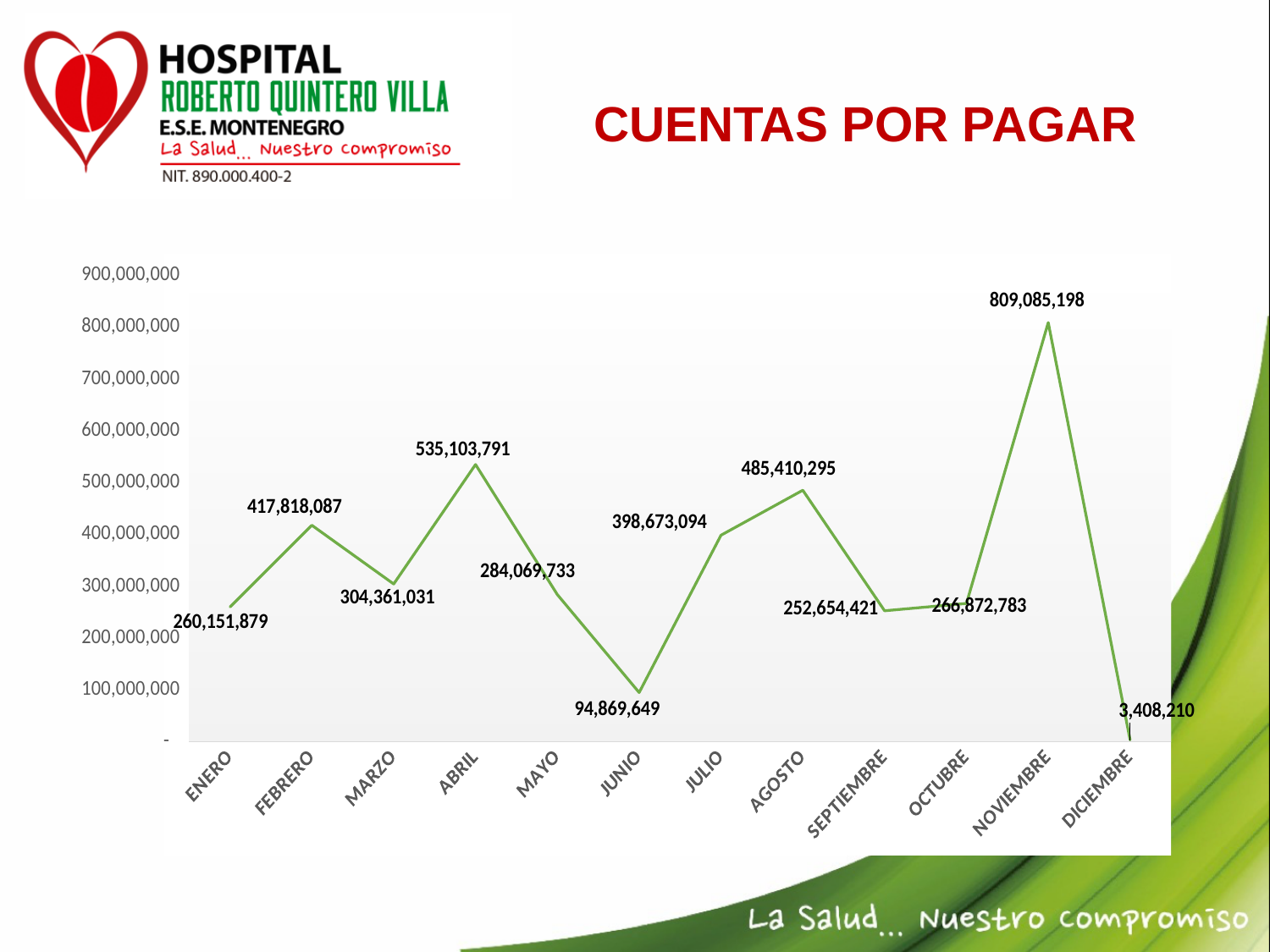
How many months are plotted on the x axis? 12 Which month has the lowest value? DICIEMBRE Which is larger, the value for FEBRERO or the value for JULIO? FEBRERO What is the difference between the values for NOVIEMBRE and DICIEMBRE? 805,676,988 What type of chart is shown on the slide? Line chart What is the value for SEPTIEMBRE? 252,654,421 Is the value for AGOSTO greater or less than 400,000,000? greater What is the value for JUNIO? 94,869,649 What is the title of the chart? CUENTAS POR PAGAR What is the difference between the values for ABRIL and MARZO? 230,742,760 Which month has the highest value? NOVIEMBRE What is the value for ABRIL? 535,103,791